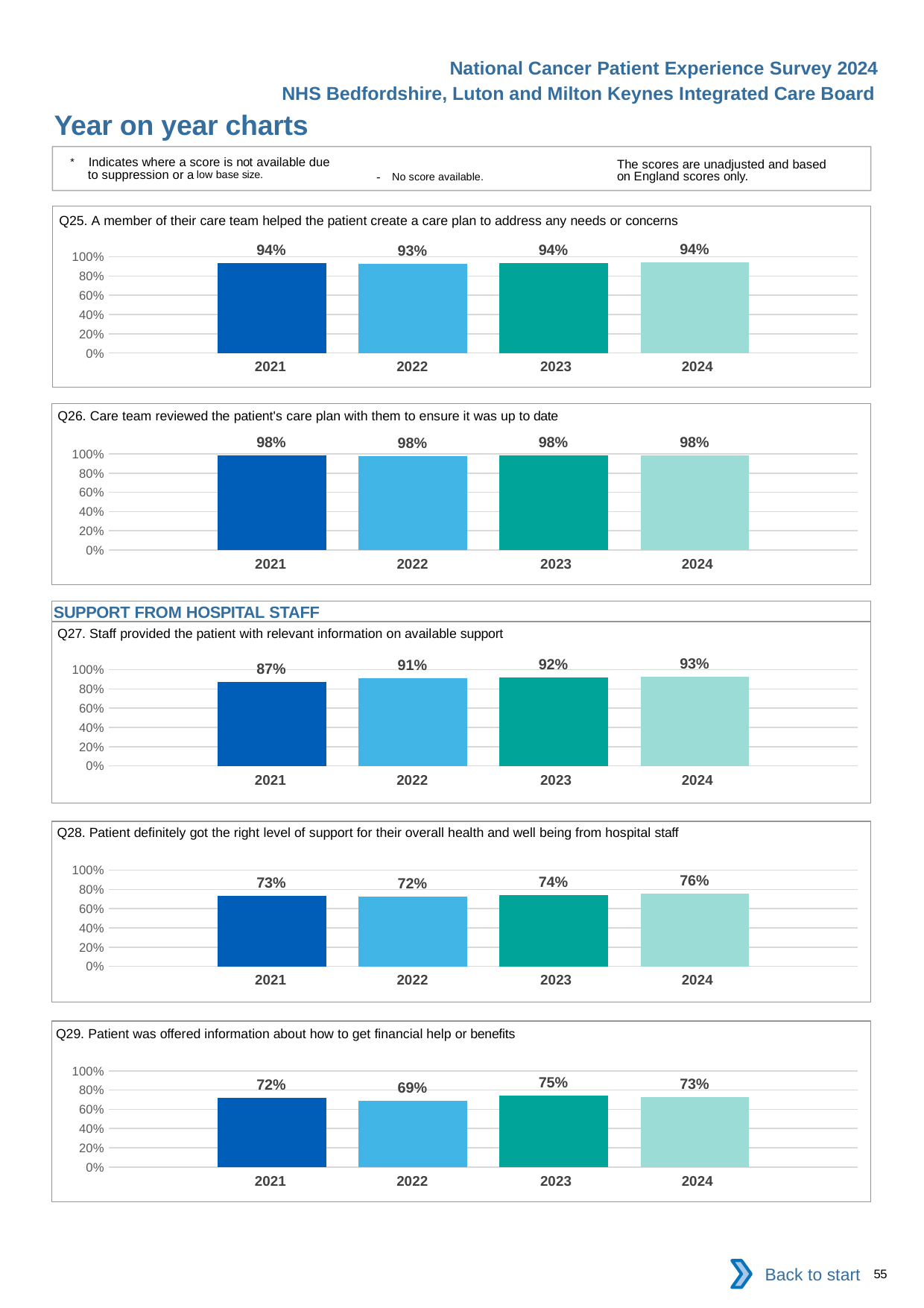
In the Q26 chart (care team reviewed the care plan), what is the value for 2024? 98% In the Q29 chart (information about financial help or benefits), what is the difference between the 2023 and 2022 values? 6 percentage points What type of chart is used for Q28 (right level of support from hospital staff)? bar chart In the Q28 chart (right level of support from hospital staff), which year has the highest value? 2024 In the Q28 chart (right level of support from hospital staff), what is the value for 2023? 74% In the Q29 chart (information about financial help or benefits), which year has the lowest value? 2022 In the Q29 chart (information about financial help or benefits), which is larger, the value for 2023 or the value for 2024? 2023 How many years are shown on the x axis of the Q25 chart? 4 In the Q27 chart (staff provided relevant information on available support), do the values rise or fall from 2021 to 2024? rise In the Q27 chart (staff provided relevant information on available support), what is the difference between the 2024 and 2021 values? 6 percentage points In the Q25 chart (care team helped create a care plan), what is the value for 2022? 93% In the Q27 chart (staff provided relevant information on available support), which year has the lowest value? 2021